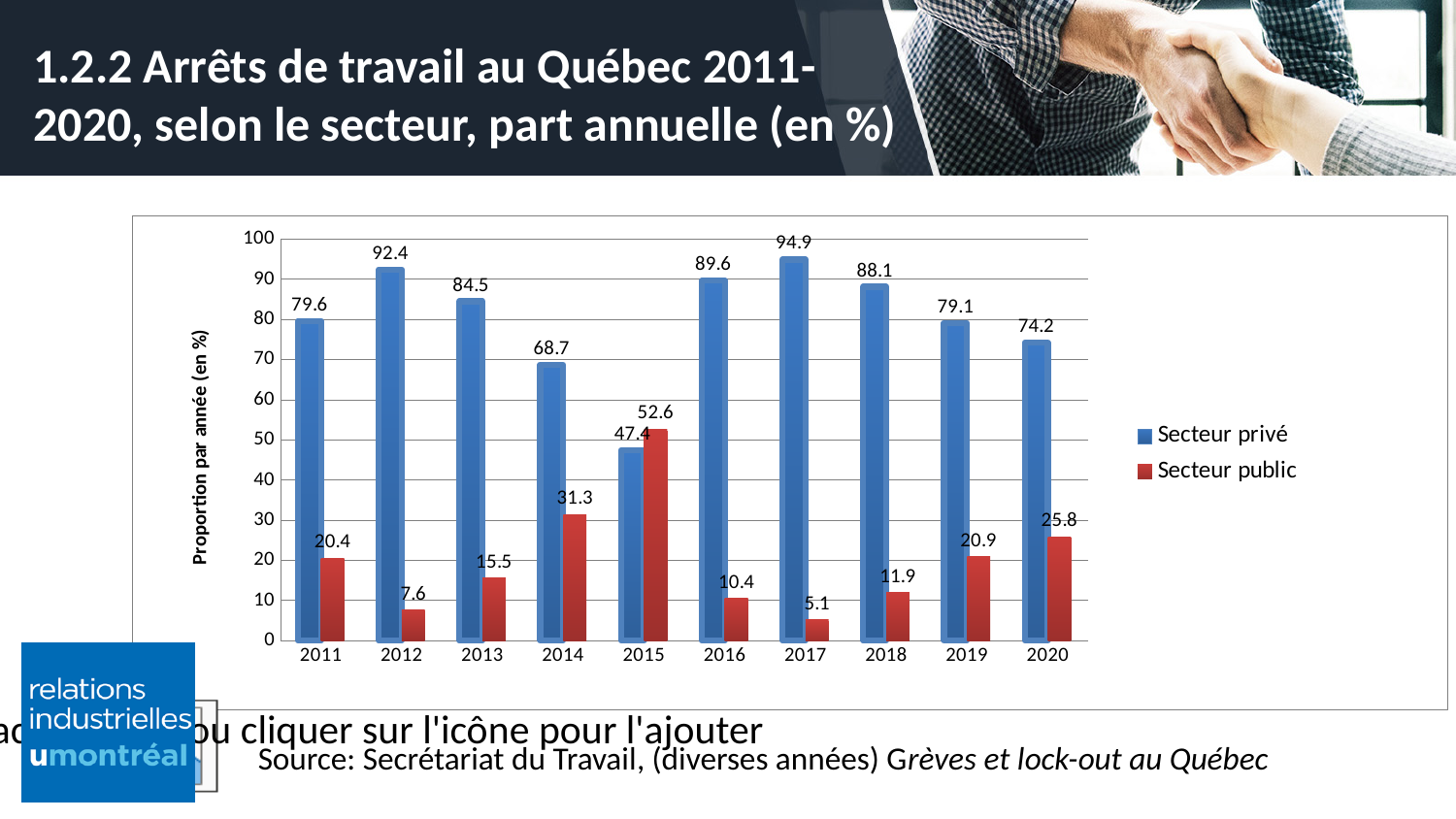
What kind of chart is shown on the slide? bar chart Which is larger in 2015: Secteur privé or Secteur public? Secteur public In which year is the Secteur privé value lowest? 2015 Is the Secteur privé value for 2014 greater or less than 70? less What is the value for Secteur public in 2014? 31.3 What is the label of the vertical axis? Proportion par année (en %) In which year is the Secteur public value highest? 2015 In which year is the Secteur public value lowest? 2017 How many series does the legend list? 2 What is the difference between the Secteur privé values for 2012 and 2011? 12.8 How many years are shown on the x axis? 10 What is the value for Secteur privé in 2017? 94.9